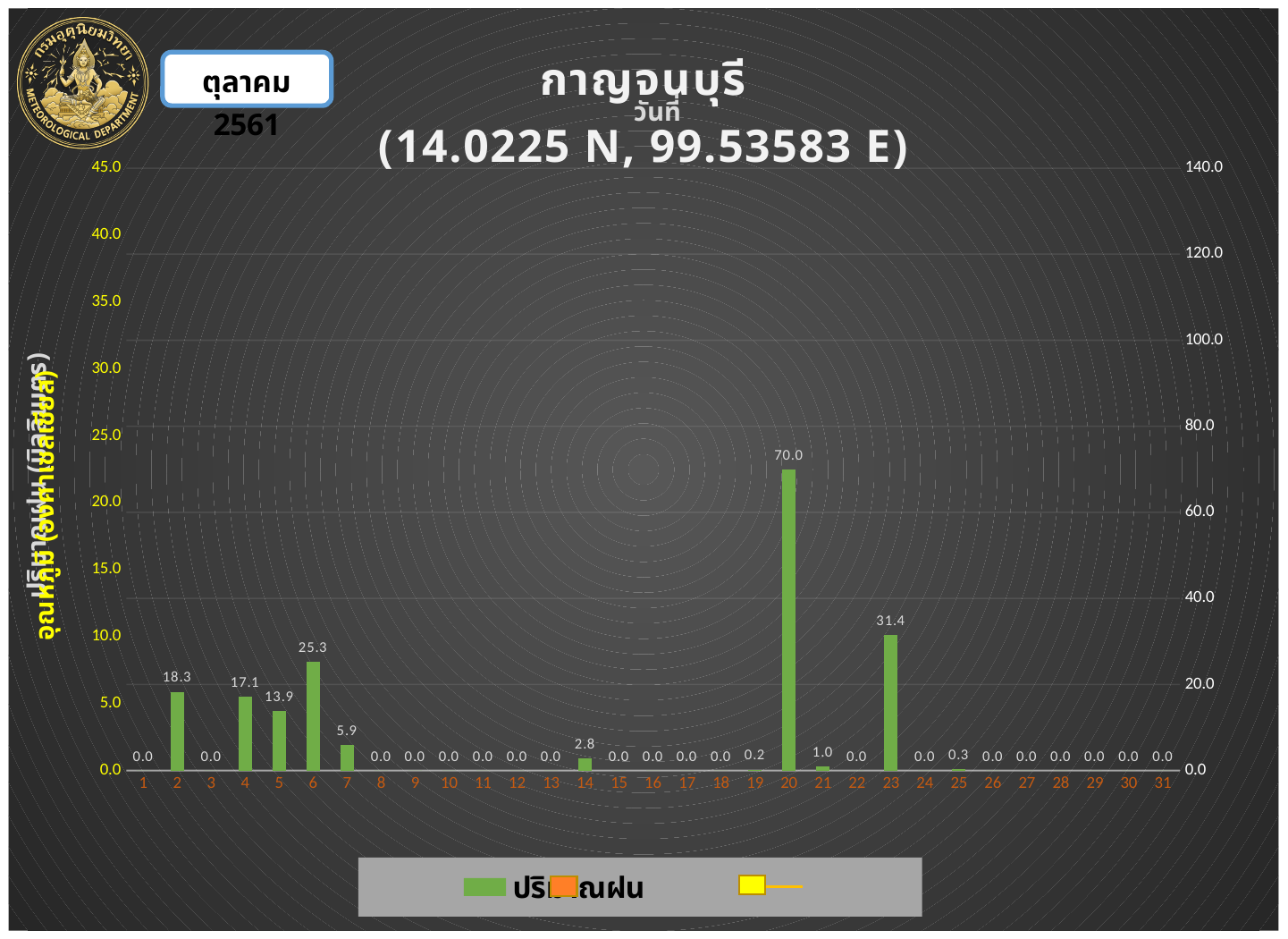
Is the bar for day 20 greater or less than 60.0 on the right-hand axis? greater What is the rainfall value shown for day 23? 31.4 What is the rainfall value shown for day 14? 2.8 What is the rainfall value shown for day 20? 70.0 What is the rainfall value shown for day 6? 25.3 What kind of chart is shown on the slide? bar chart What is the difference between the rainfall values for day 2 and day 4? 1.2 What station name appears in the chart title? กาญจนบุรี Which day has the larger rainfall value, day 4 or day 5? day 4 Which day has the highest rainfall value? 20 How many days are shown along the x axis? 31 What is the difference between the rainfall values for day 20 and day 23? 38.6